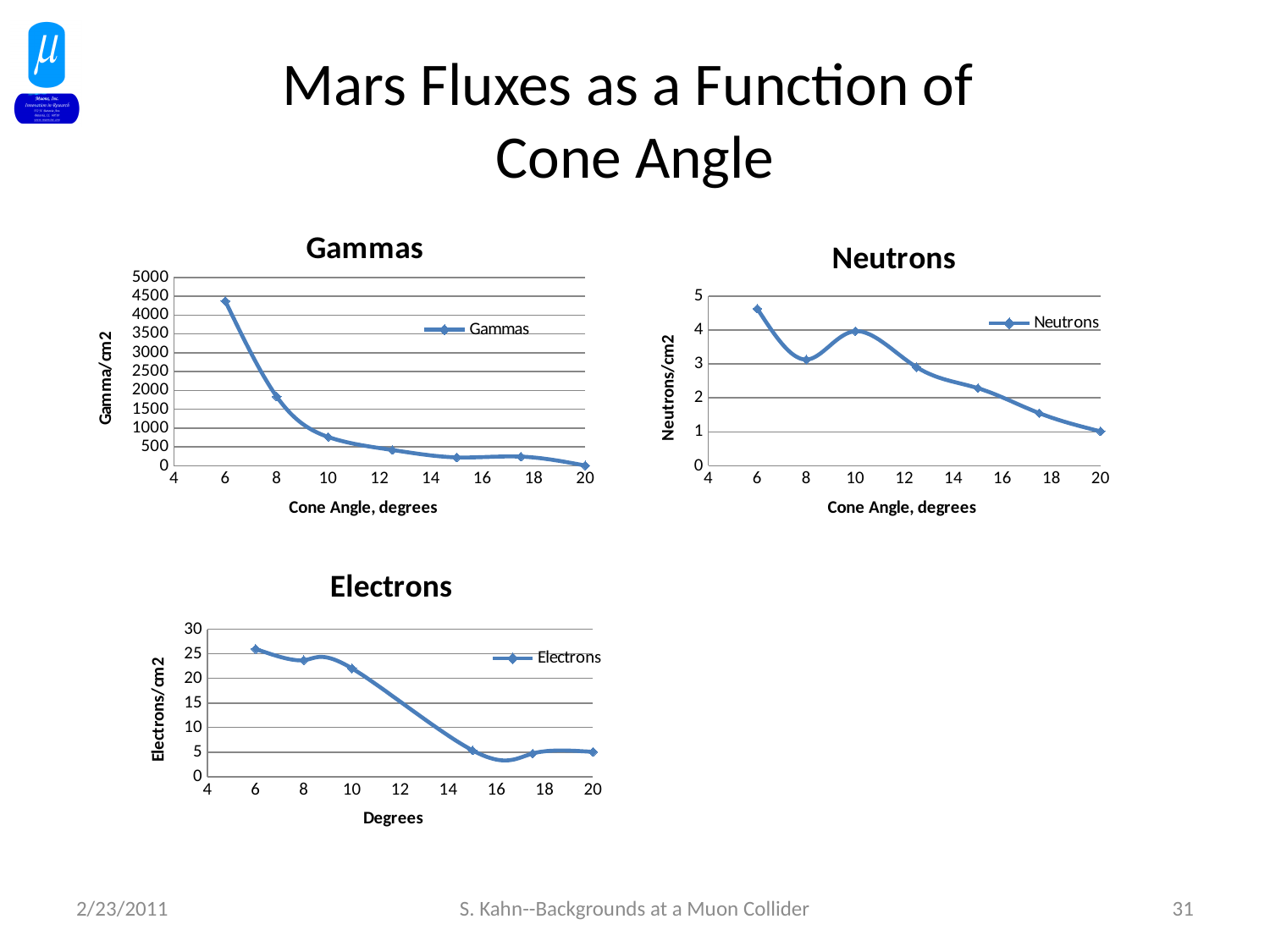
What kind of chart is the Gammas chart? line chart In the Neutrons chart, at which cone angle is the neutron flux highest? 6 In the Electrons chart, is the value at a cone angle of 10 degrees greater or less than 20? greater How many data points are plotted in the Neutrons chart? 7 In the Gammas chart, is the value at a cone angle of 6 degrees greater or less than 4000? greater What is the y-axis title of the Electrons chart? Electrons/cm2 In the Neutrons chart, at which cone angle is the neutron flux lowest? 20 In the Gammas chart, at which cone angle is the gamma flux highest? 6 In the Gammas chart, is the value at a cone angle of 20 degrees greater or less than 500? less In the Gammas chart, do the values generally rise or fall as the cone angle increases? fall How many series does the legend of the Electrons chart list? 1